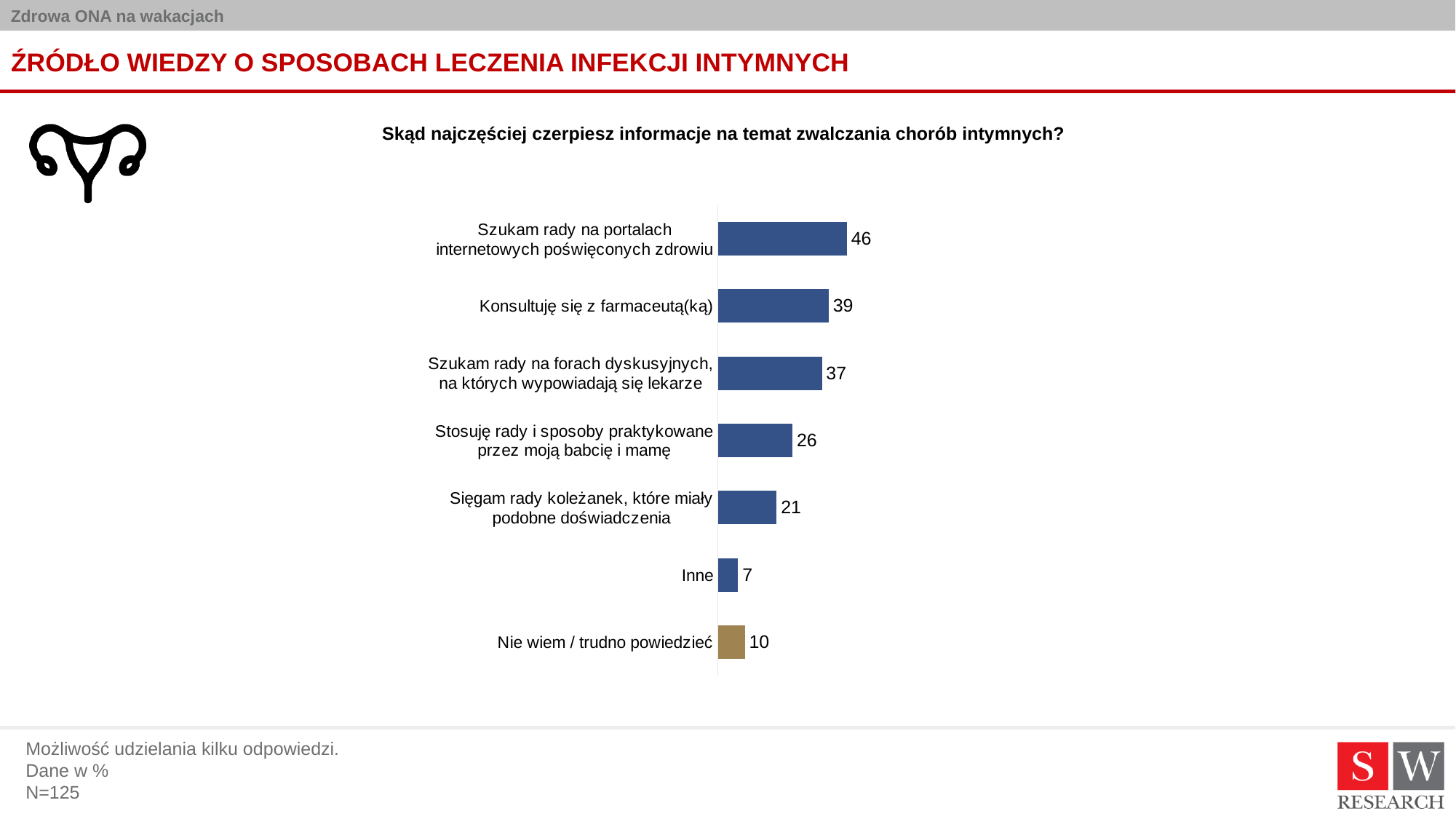
Which is larger: the value for "Szukam rady na forach dyskusyjnych, na których wypowiadają się lekarze" or the value for "Stosuję rady i sposoby praktykowane przez moją babcię i mamę"? Szukam rady na forach dyskusyjnych, na których wypowiadają się lekarze What kind of chart is shown on the slide? Bar chart What question is shown as the chart's title? Skąd najczęściej czerpiesz informacje na temat zwalczania chorób intymnych? What is the value for "Inne"? 7 Which category has the highest value? Szukam rady na portalach internetowych poświęconych zdrowiu What is the value for "Konsultuję się z farmaceutą(ką)"? 39 What is the difference between the values for "Stosuję rady i sposoby praktykowane przez moją babcię i mamę" and "Sięgam rady koleżanek, które miały podobne doświadczenia"? 5 How many categories are shown in the chart? 7 What is the value for "Nie wiem / trudno powiedzieć"? 10 Which category has the lowest value? Inne What is the difference between the values for "Szukam rady na portalach internetowych poświęconych zdrowiu" and "Konsultuję się z farmaceutą(ką)"? 7 Which category's bar is shown in a different colour from the others? Nie wiem / trudno powiedzieć